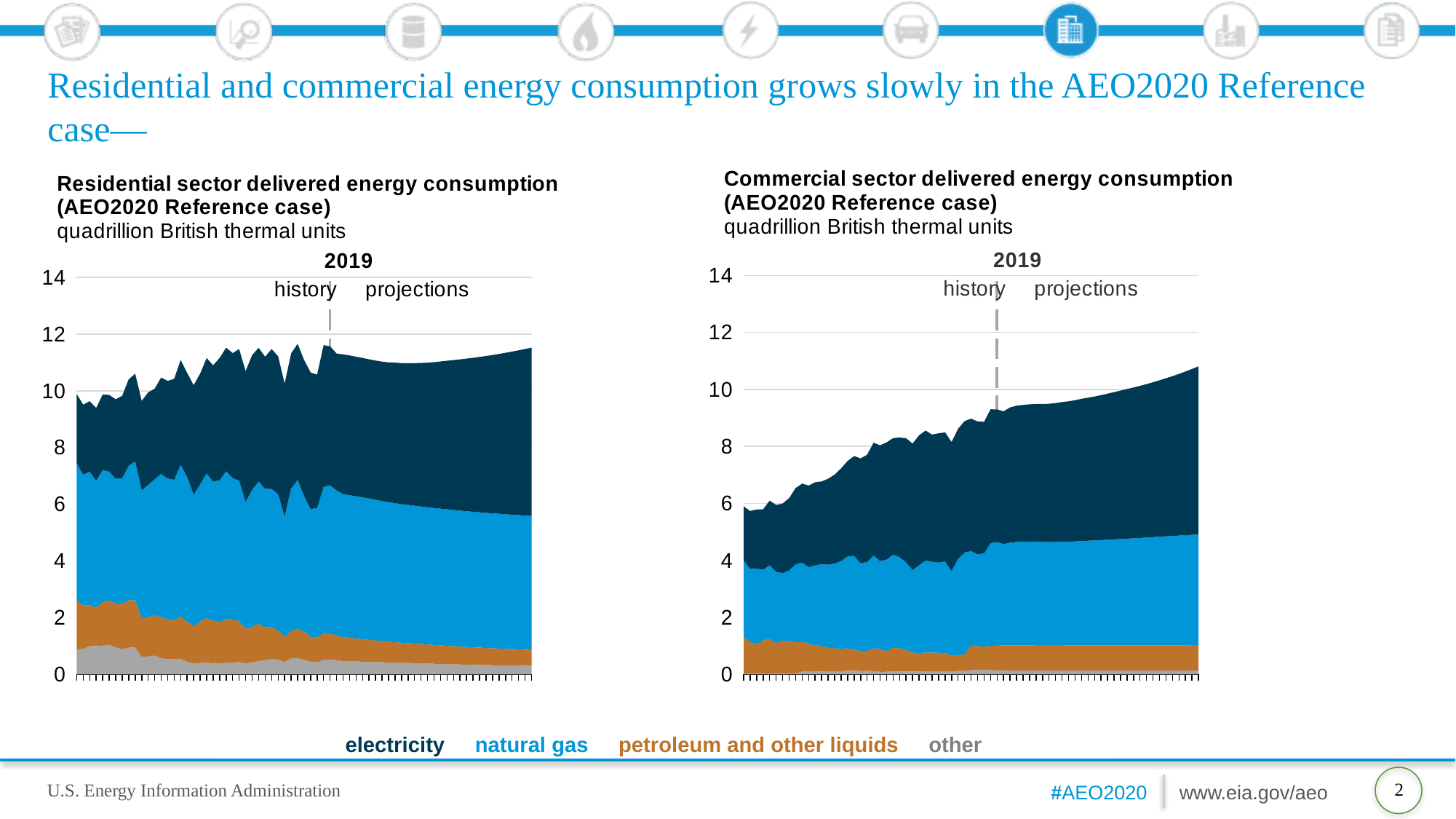
In the Commercial sector chart, does total delivered energy consumption rise or fall over the projection period? rise How many series does the shared legend list for the two charts? 4 In the Residential sector chart, is the total delivered energy consumption at the end of the projection period greater or less than 10? greater In the Commercial sector chart, is the total delivered energy consumption at the start of the history period greater or less than 8? less What unit is used on the y axis of the Commercial sector delivered energy consumption chart? quadrillion British thermal units In the Residential sector chart, which fuel has the smallest share of consumption at the end of the projection period? other In the Commercial sector chart, is the total delivered energy consumption at the end of the projection period greater or less than 10? greater In the Commercial sector chart, which is larger at the end of the projection period: natural gas or petroleum and other liquids? natural gas In the Residential sector chart, which fuel has the largest share of consumption at the end of the projection period? electricity What kind of chart is the Residential sector delivered energy consumption chart? stacked area chart In the Residential sector chart, which year separates history from projections? 2019